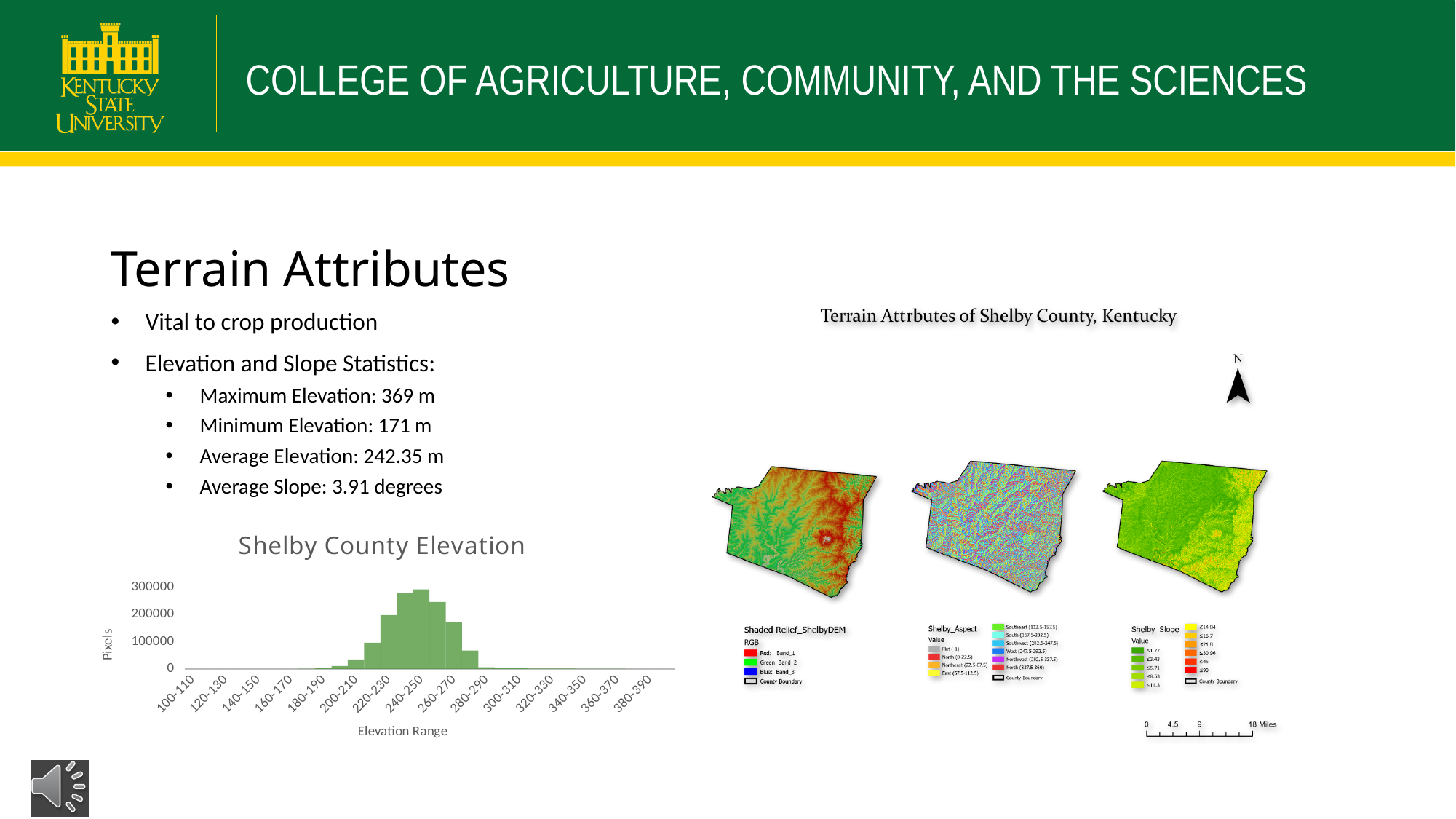
How many elevation range labels are shown along the x axis of the Shelby County Elevation chart? 15 Is the value for the 260-270 elevation range greater or less than 200000? less Is the value for the 280-290 elevation range greater or less than 100000? less What kind of chart is the Shelby County Elevation chart? bar chart Which has more pixels in the Shelby County Elevation chart, the 240-250 range or the 280-290 range? 240-250 Which has more pixels in the Shelby County Elevation chart, the 260-270 range or the 200-210 range? 260-270 Is the value for the 240-250 elevation range greater or less than 200000? greater Which elevation range has the highest pixel count in the Shelby County Elevation chart? 240-250 What is the label of the y axis on the Shelby County Elevation chart? Pixels What is the title of the chart on the slide? Shelby County Elevation Do the pixel counts rise or fall from the 240-250 range to the 280-290 range in the Shelby County Elevation chart? fall